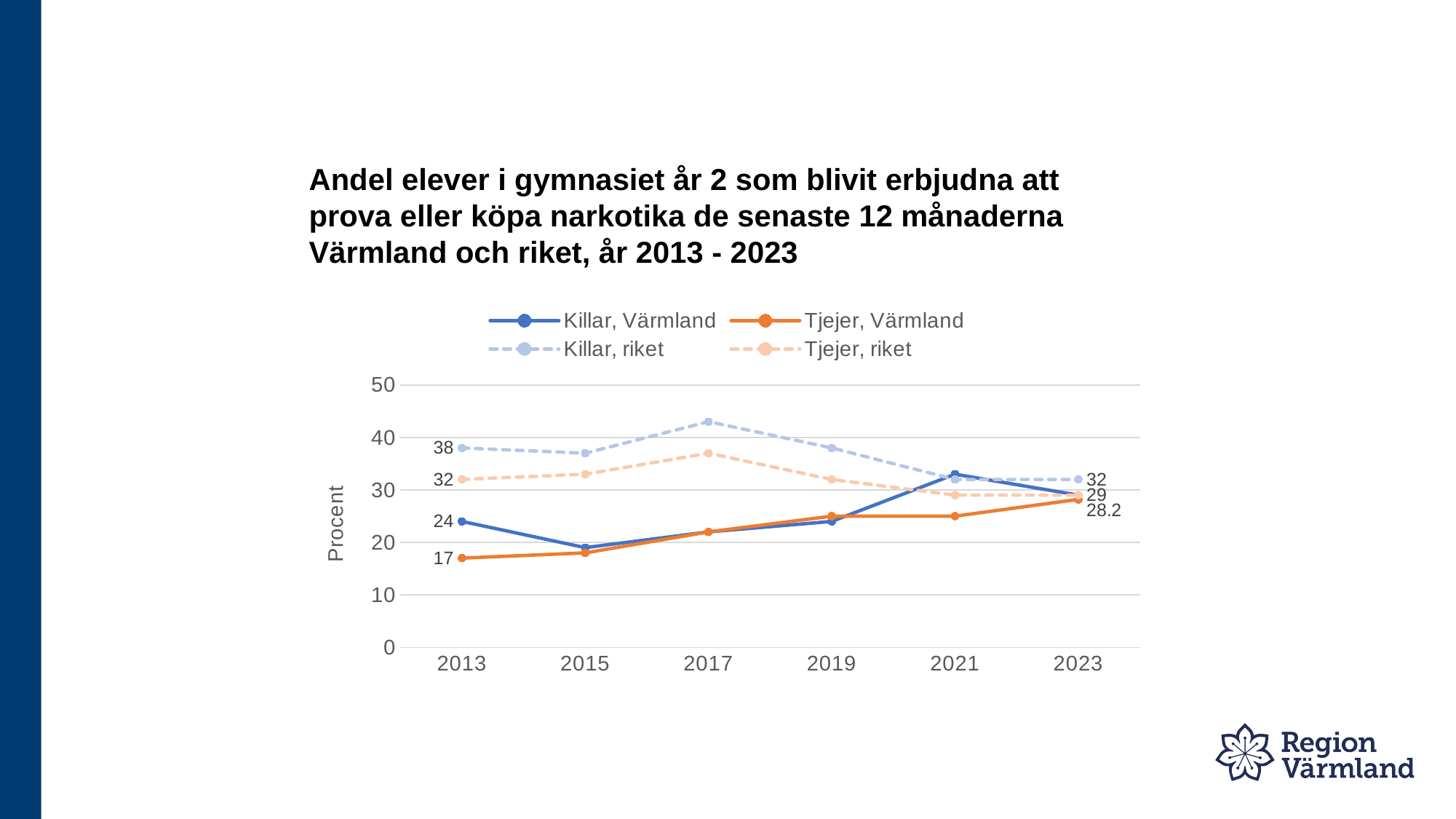
Is the value for Killar, riket in 2017 greater or less than 40? greater What is the difference between Killar, Värmland and Tjejer, Värmland in 2013? 7 What kind of chart is shown on the slide? line chart In 2013, which is larger: Killar, riket or Tjejer, riket? Killar, riket Which series has the highest value in 2013? Killar, riket What is the value for Killar, Värmland in 2013? 24 How many series does the legend list? 4 Which series has the lowest value in 2013? Tjejer, Värmland What is the value for Killar, riket in 2013? 38 What is the value for Tjejer, Värmland in 2013? 17 How many years are shown on the x axis? 6 What is the value for Killar, riket in 2023? 32